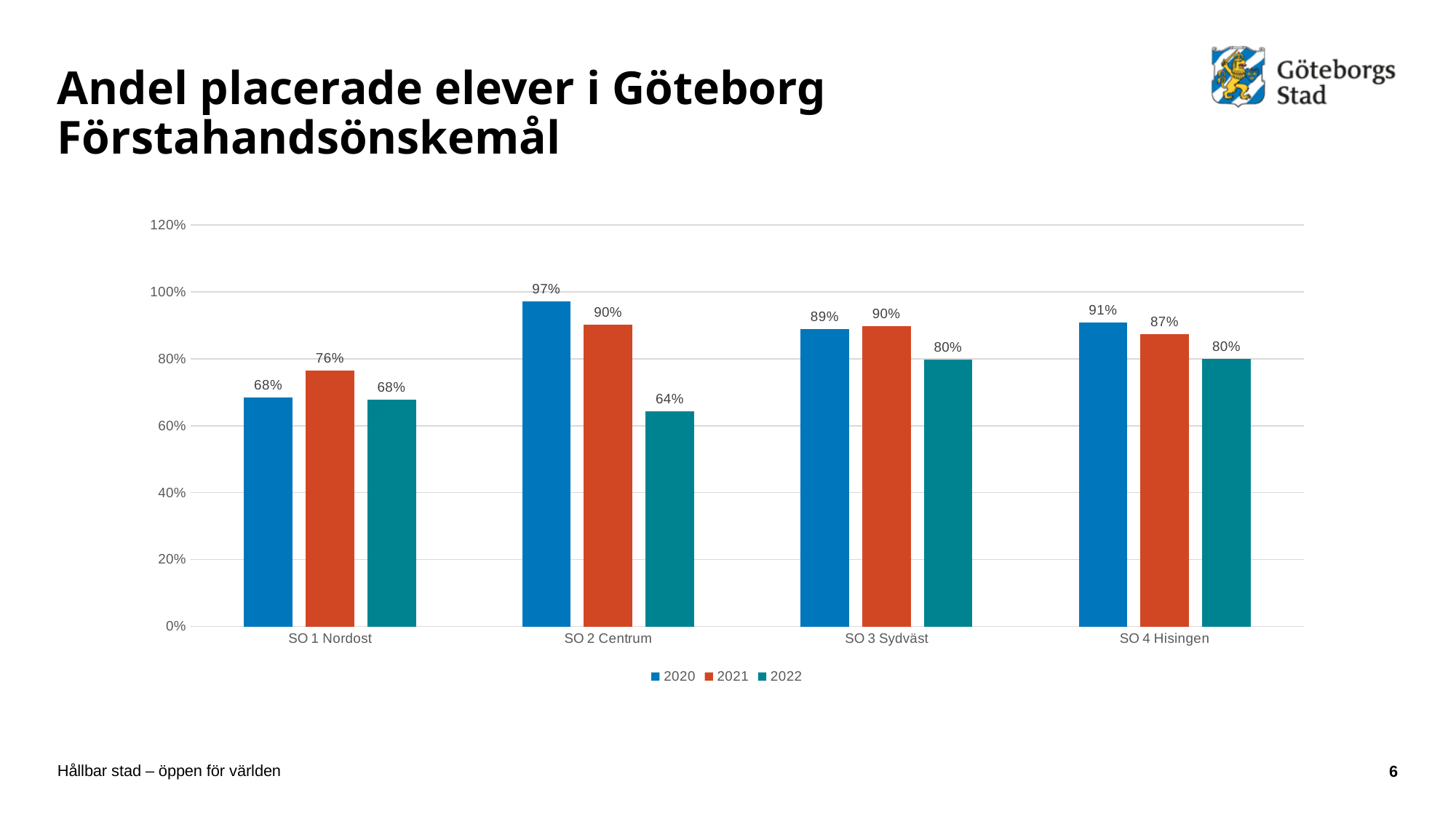
What is the difference between the 2020 and 2022 values for SO 2 Centrum? 33% What kind of chart is shown on the slide? bar chart Which is larger for SO 3 Sydväst: the 2020 value or the 2021 value? 2021 What is the value for SO 4 Hisingen in 2022? 80% What is the value for SO 2 Centrum in 2020? 97% How many categories are shown on the x axis? 4 What is the value for SO 1 Nordost in 2021? 76% Which category has the highest value in the 2020 series? SO 2 Centrum Which category has the lowest value in the 2022 series? SO 2 Centrum Which colour represents the 2021 series in the legend? orange How many series does the legend list? 3 Is the 2022 value for SO 1 Nordost greater or less than 80%? less